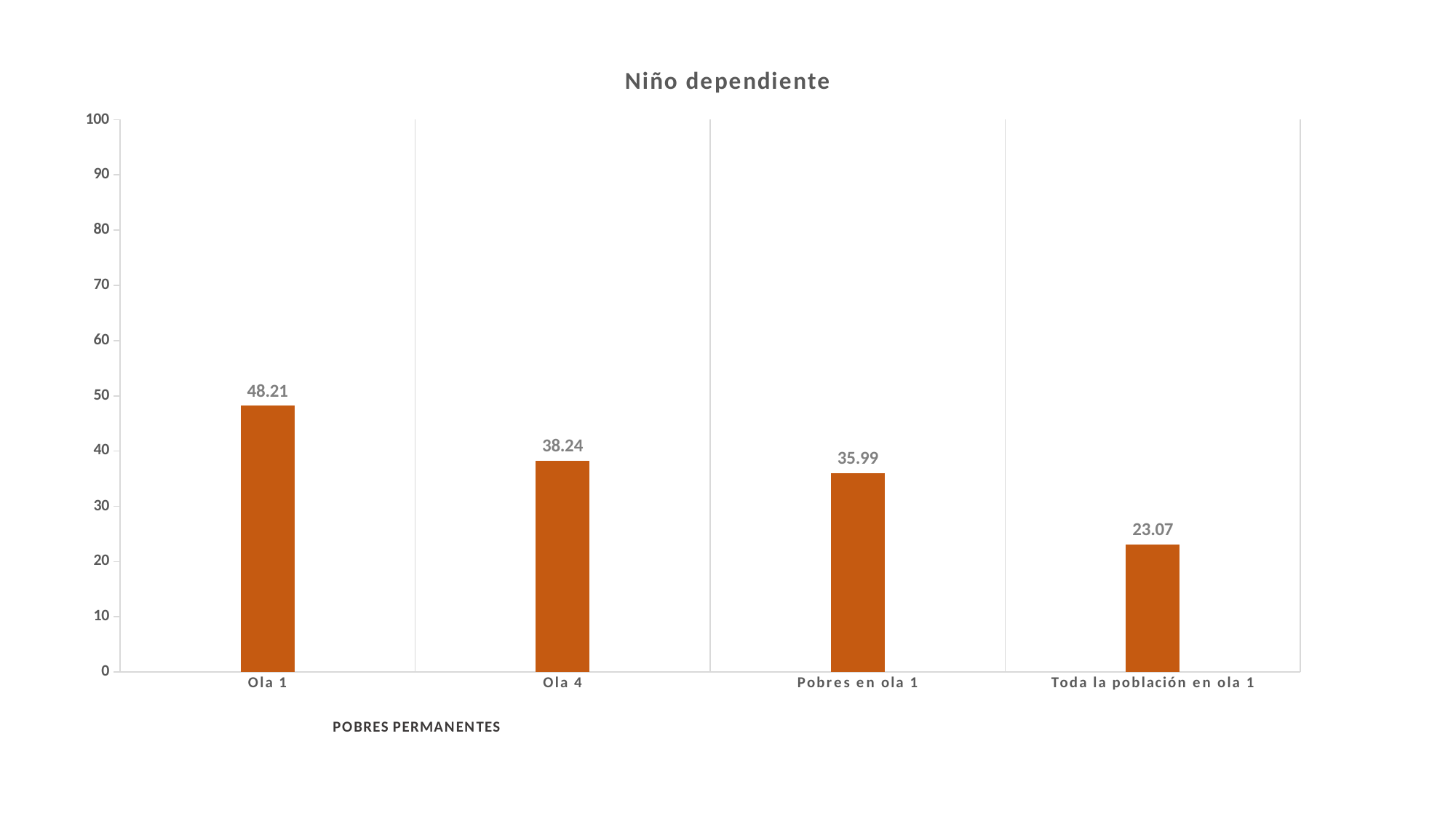
What kind of chart is this? bar chart What is the title of the chart? Niño dependiente What is the value for Ola 4? 38.24 Which is larger, the value for Ola 4 or the value for Pobres en ola 1? Ola 4 What is the value for Toda la población en ola 1? 23.07 What is the value for Ola 1? 48.21 What is the value for Pobres en ola 1? 35.99 How many categories are shown on the x axis? 4 Which category has the lowest value? Toda la población en ola 1 Is the value for Toda la población en ola 1 greater or less than 30? less What is the difference between the values for Ola 1 and Ola 4? 9.97 Which category has the highest value? Ola 1